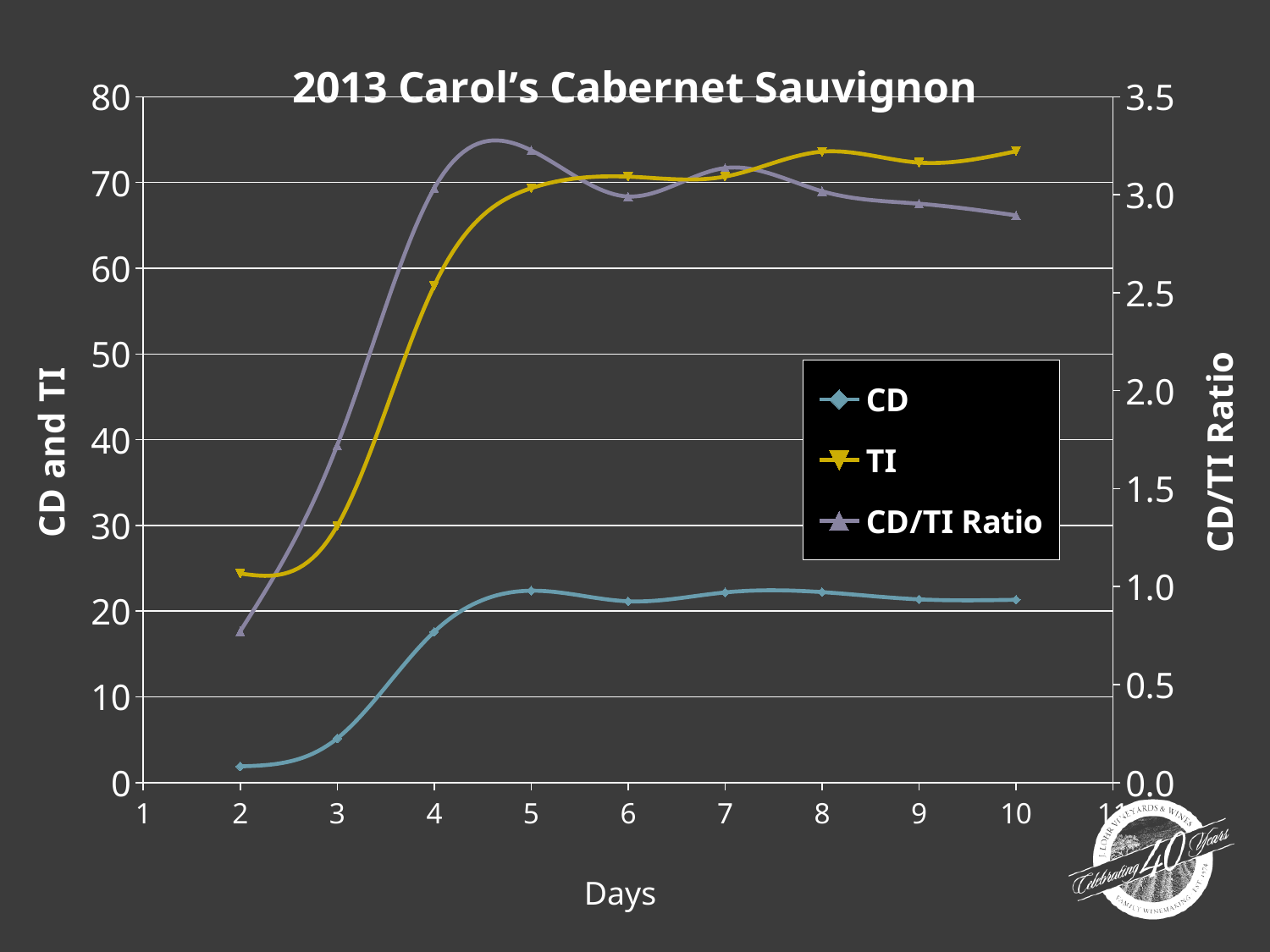
What is the label of the right-hand vertical axis? CD/TI Ratio On which day is the CD value lowest? 2 Is the CD/TI Ratio value at day 2 greater or less than 1.0? less How many series does the legend list? 3 What kind of chart is shown on the slide? line chart On which day is the CD/TI Ratio value highest? 5 Is the TI value at day 2 greater or less than 30? less Does the CD series rise or fall from day 2 to day 5? rise Is the TI value at day 10 greater or less than 70? greater How many data points are plotted for the CD series? 9 What is the title of the chart? 2013 Carol's Cabernet Sauvignon